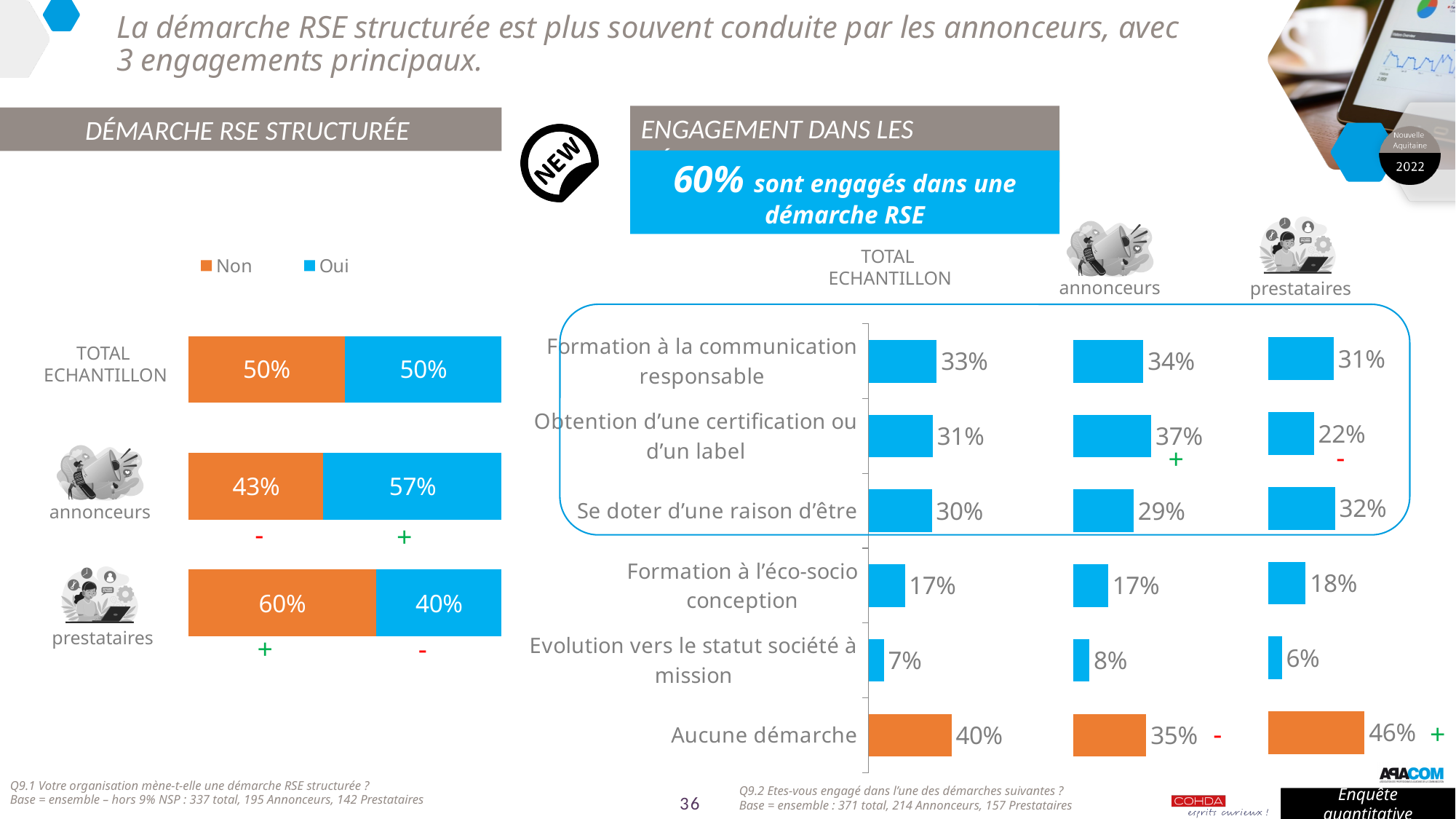
In the 'DÉMARCHE RSE STRUCTURÉE' chart on the left, what is the 'Oui' value for annonceurs? 57% In the 'DÉMARCHE RSE STRUCTURÉE' chart on the left, how many series does the legend list? 2 In the right-hand engagement chart, what is the TOTAL ECHANTILLON value for 'Formation à la communication responsable'? 33% In the 'DÉMARCHE RSE STRUCTURÉE' chart on the left, which group has the highest 'Oui' value? annonceurs In the right-hand engagement chart, what is the annonceurs value for 'Obtention d'une certification ou d'un label'? 37% What kind of chart is the 'DÉMARCHE RSE STRUCTURÉE' chart on the left? Stacked bar chart In the 'DÉMARCHE RSE STRUCTURÉE' chart on the left, what is the difference between the 'Non' and 'Oui' values for annonceurs? 14% In the right-hand engagement chart, is the annonceurs value or the prestataires value larger for 'Obtention d'une certification ou d'un label'? annonceurs In the right-hand engagement chart, which category has the lowest TOTAL ECHANTILLON value? Evolution vers le statut société à mission In the right-hand engagement chart, what is the prestataires value for 'Aucune démarche'? 46% In the 'DÉMARCHE RSE STRUCTURÉE' chart on the left, what is the 'Non' value for prestataires? 60% In the right-hand engagement chart, how many categories are listed? 6